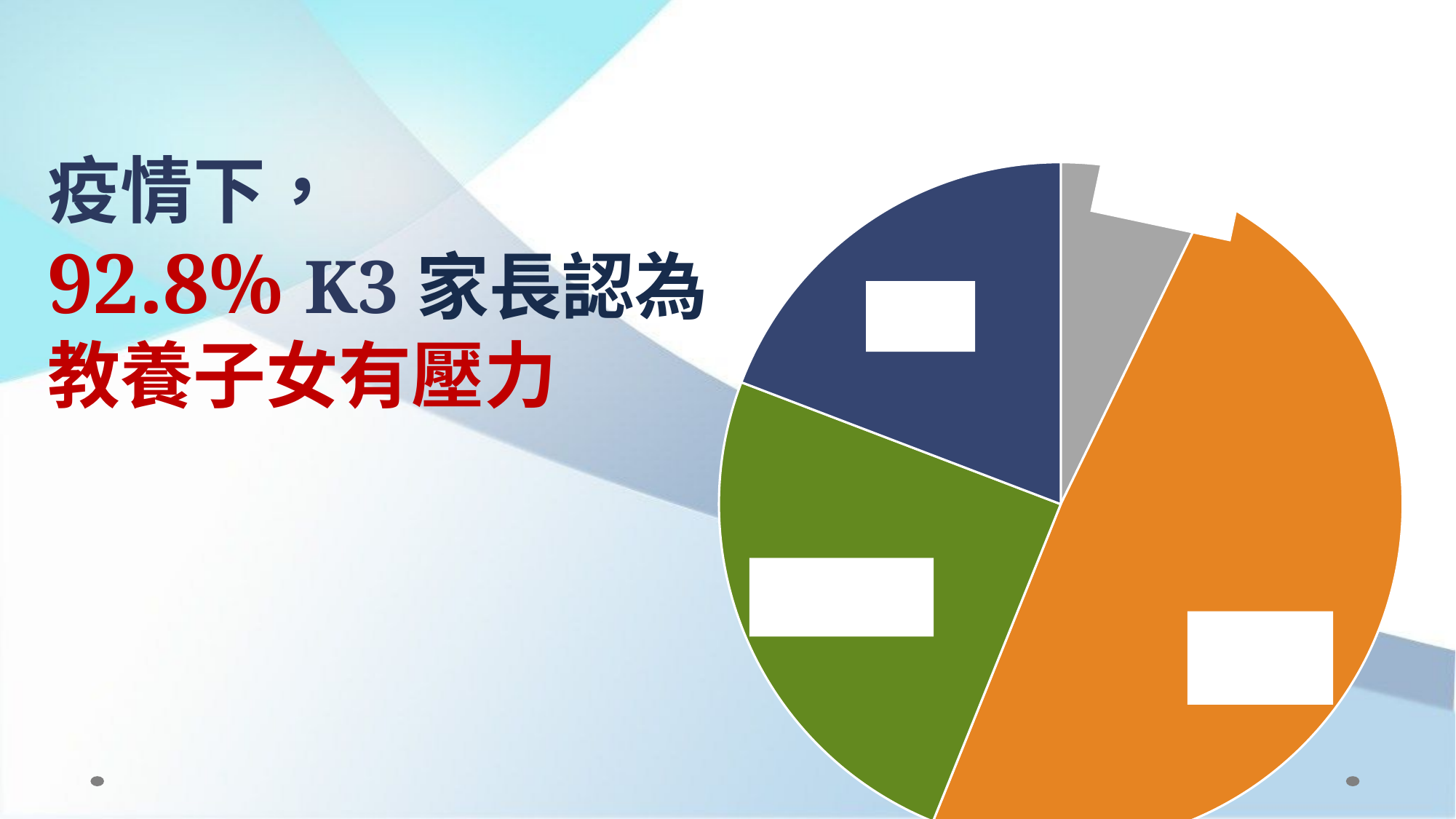
What kind of chart is shown on the slide? pie chart Which is larger in the pie chart, the blue slice or the grey slice? blue Which colour slice is pulled out (exploded) from the pie chart? orange Which is larger in the pie chart, the orange slice or the green slice? orange Which colour slice is the largest in the pie chart? orange Which is larger in the pie chart, the green slice or the grey slice? green How many slices does the pie chart have? 4 What percentage is highlighted in red in the slide text next to the pie chart? 92.8% Which colour slice is the smallest in the pie chart? grey